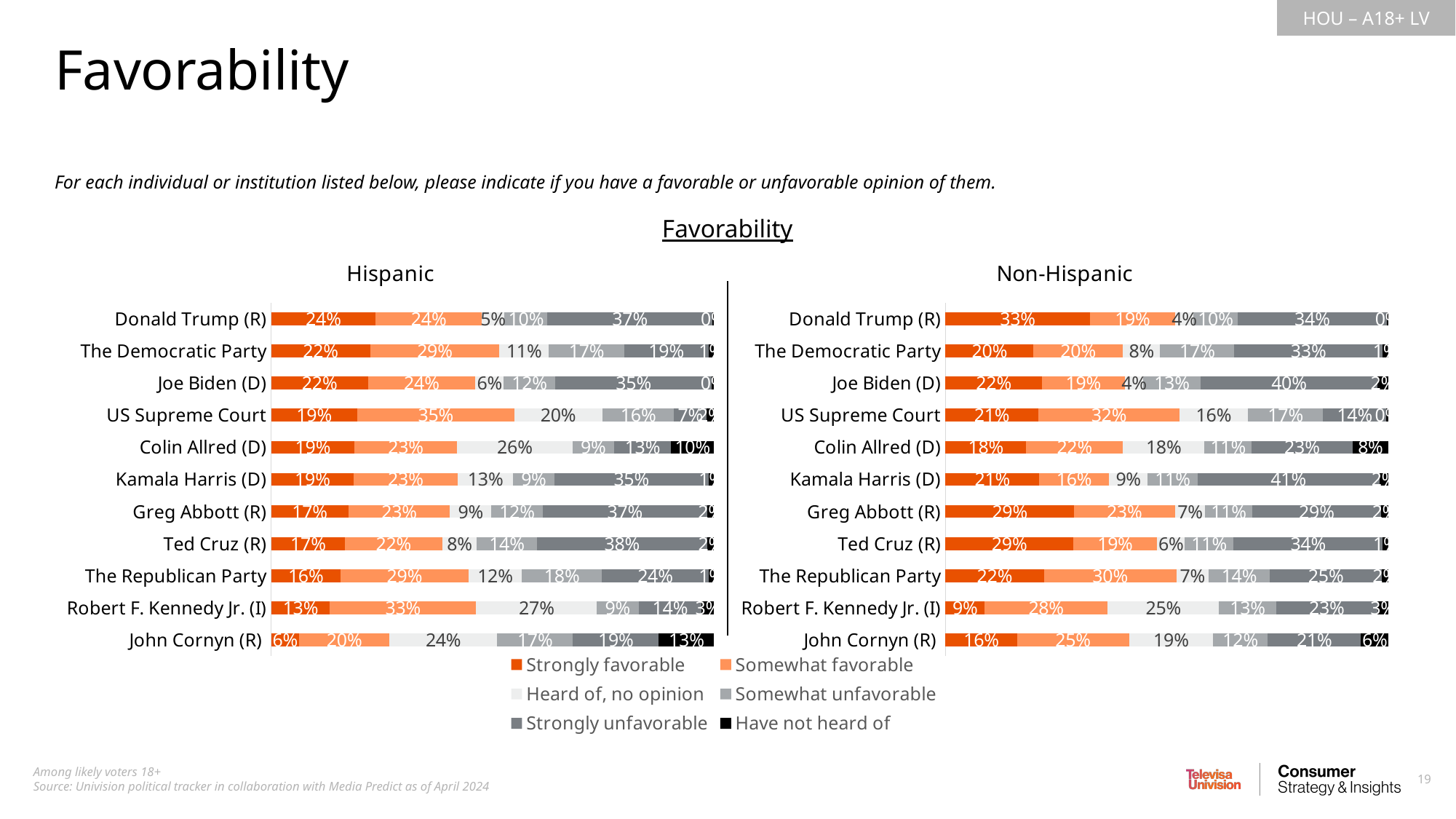
In the Non-Hispanic chart, which category has the highest Strongly favorable value? Donald Trump (R) How many categories are shown in the Hispanic chart? 11 In the Non-Hispanic chart, which is larger: the Strongly favorable value for Greg Abbott (R) or for Joe Biden (D)? Greg Abbott (R) In the Non-Hispanic chart, what is the Somewhat favorable value for The Republican Party? 30% In the Hispanic chart, what is the Strongly favorable value for Donald Trump (R)? 24% How many series does the legend list? 6 In the Hispanic chart, what is the Have not heard of value for John Cornyn (R)? 13% What kind of chart is used for the Non-Hispanic data? Stacked bar chart In the Hispanic chart, what is the Heard of, no opinion value for Robert F. Kennedy Jr. (I)? 27% In the Hispanic chart, which category has the lowest Strongly favorable value? John Cornyn (R) In the Non-Hispanic chart, what is the Strongly unfavorable value for Kamala Harris (D)? 41% In the Hispanic chart, what is the difference between the Strongly unfavorable values for Ted Cruz (R) and The Republican Party? 14%